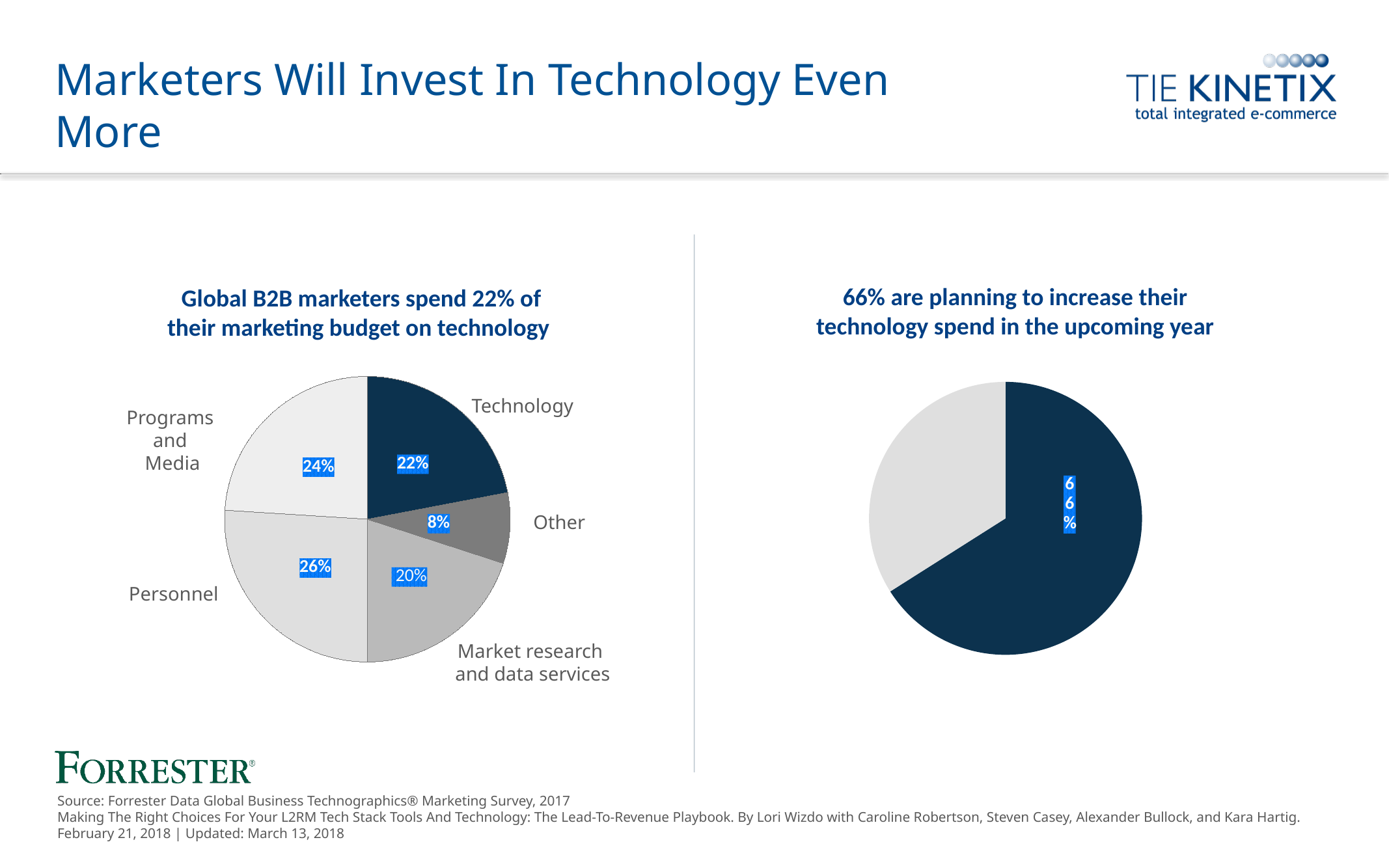
In the left pie chart, what share of the marketing budget is spent on Technology? 22% What type of chart is used on the left side of the slide? Pie chart In the left pie chart, which is larger: the share for Programs and Media or the share for Market research and data services? Programs and Media In the left pie chart, which category has the largest share of the marketing budget? Personnel In the left pie chart, what percentage is labelled for Programs and Media? 24% In the left pie chart, which category has the smallest share of the marketing budget? Other In the left pie chart, what is the difference between the Personnel share and the Technology share? 4% How many categories does the left pie chart show? 5 In the left pie chart, what percentage is labelled for Market research and data services? 20% In the right pie chart, what percentage is shown on the dark blue slice? 66% What is the title of the chart on the right side of the slide? 66% are planning to increase their technology spend in the upcoming year In the left pie chart, what share of the marketing budget goes to Personnel? 26%